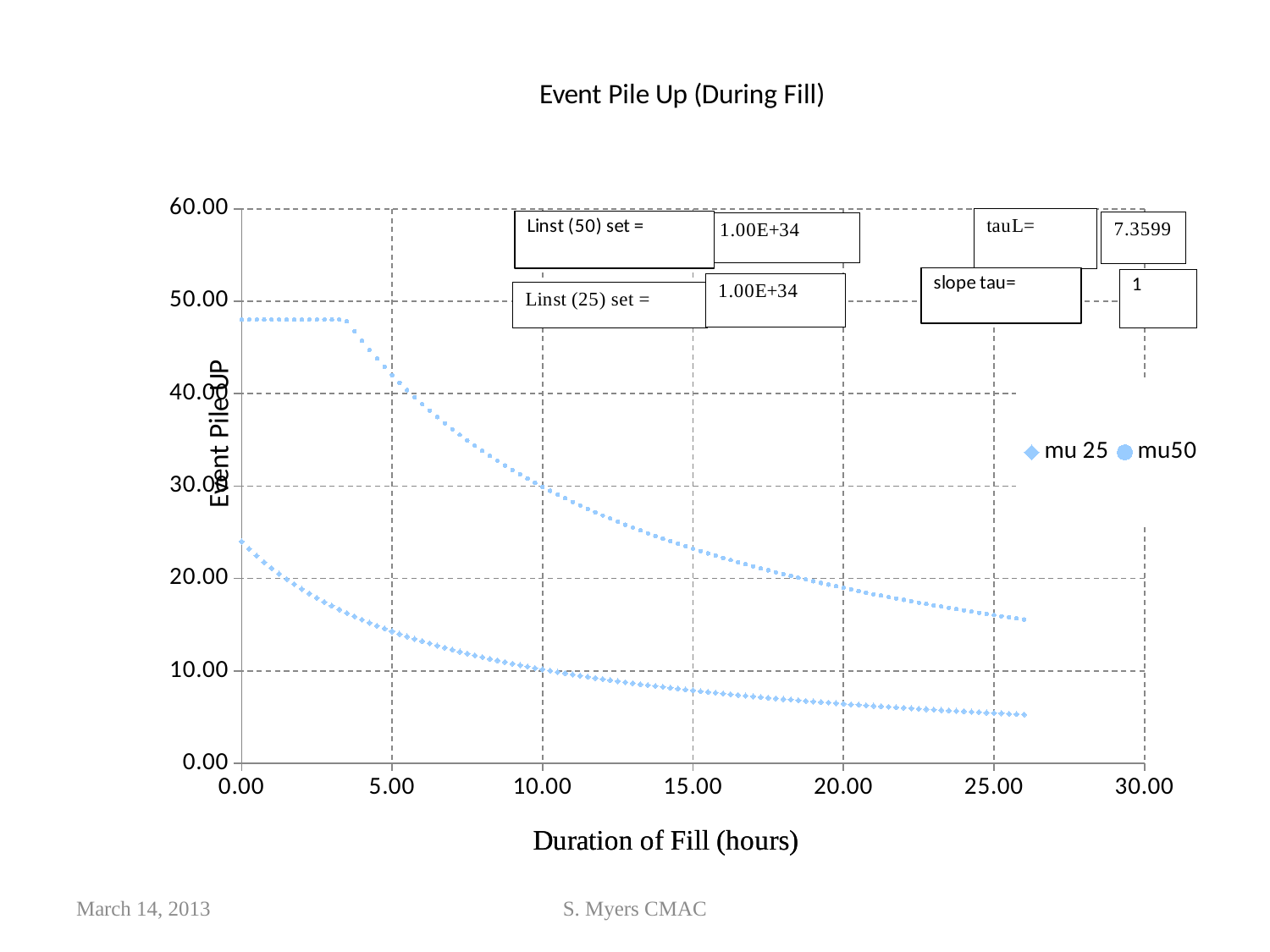
How many series does the legend list? 2 What is the title of the chart? Event Pile Up (During Fill) Is the value of the mu50 series at 25.00 hours greater or less than 20.00? less Do the values of the mu50 series rise or fall as the duration of fill increases? fall What kind of chart is shown on the slide? scatter chart Is the value of the mu 25 series at 5.00 hours greater or less than 10.00? greater Do the values of the mu 25 series rise or fall as the duration of fill increases? fall Which series has the larger value at 10.00 hours, mu 25 or mu50? mu50 Is the value of the mu50 series at 0.00 hours greater or less than 40.00? greater What is the label of the x axis? Duration of Fill (hours)